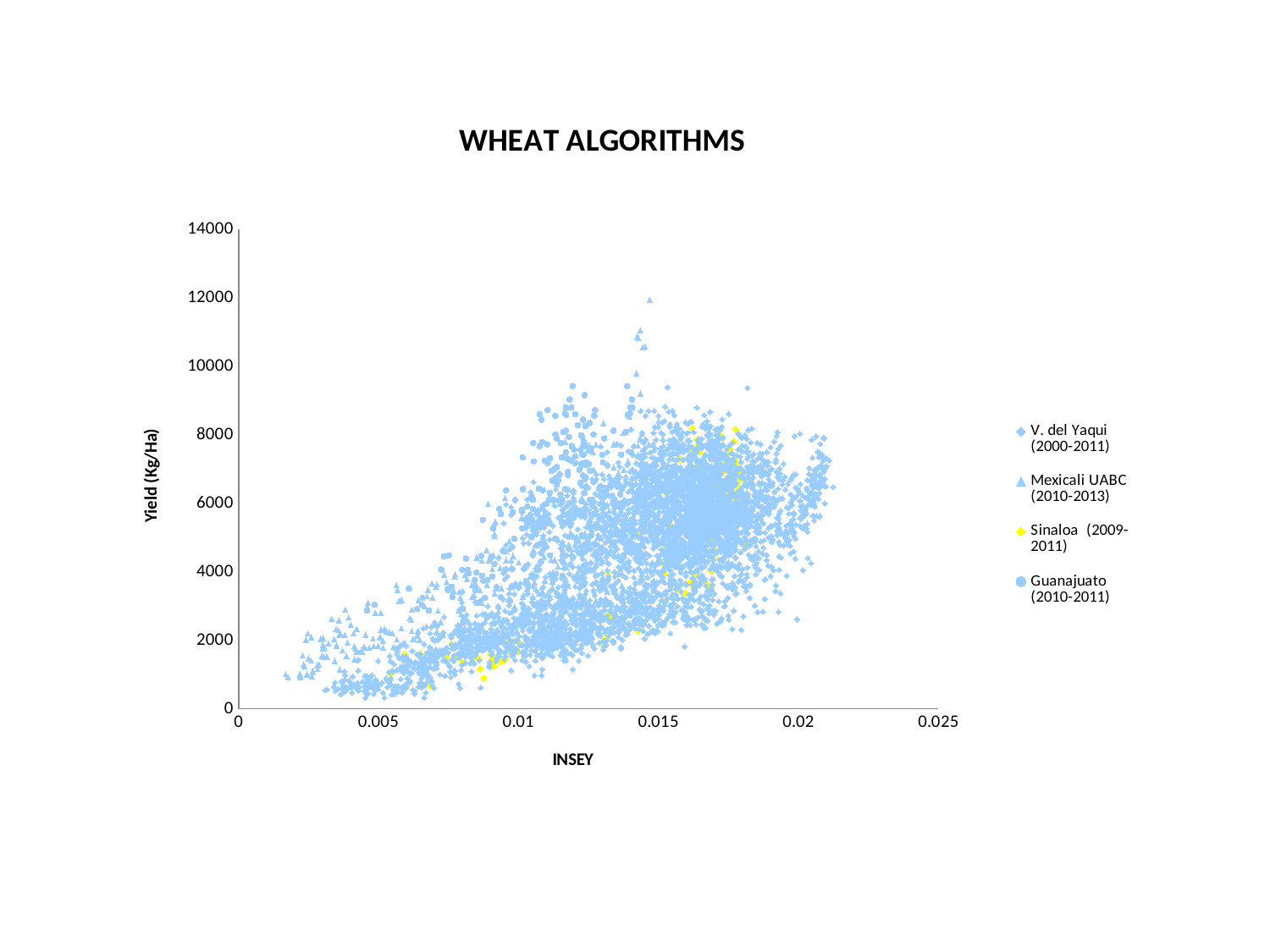
Is the largest INSEY value plotted on the chart greater or less than 0.02? greater How many series does the legend list? 4 What is the title of the chart? WHEAT ALGORITHMS Is the highest yield value plotted on the chart greater or less than 10000? greater Is the lowest yield value plotted on the chart greater or less than 2000? less As INSEY increases along the x axis, do the plotted yield values generally rise or fall? rise What kind of chart is shown on the slide? scatter chart Which series is plotted with yellow markers? Sinaloa (2009-2011)